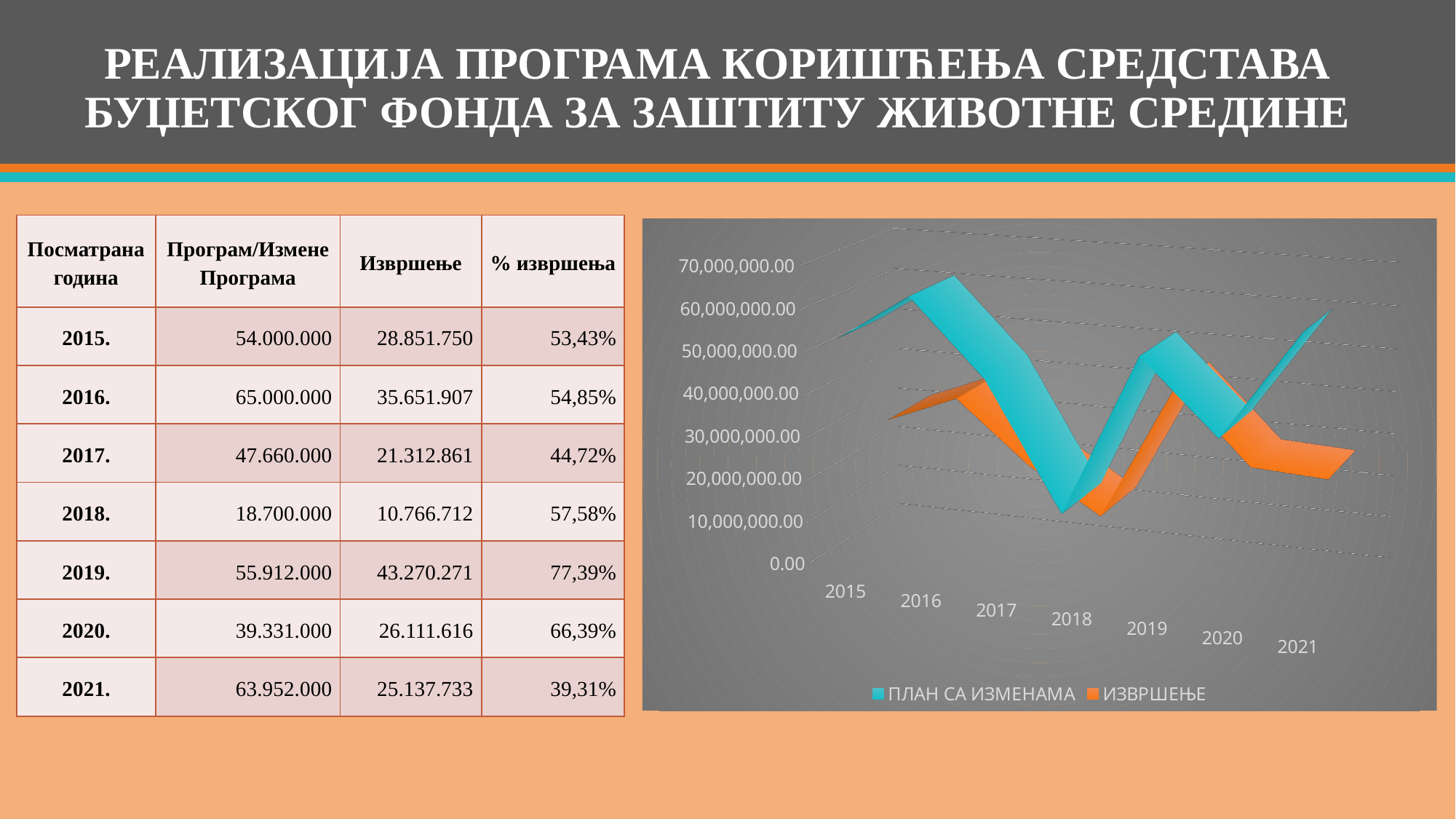
Which year has the lowest value for ИЗВРШЕЊЕ in the chart? 2018 Does the ПЛАН СА ИЗМЕНАМА series rise or fall from 2016 to 2018? fall Which series in the chart legend is shown in orange? ИЗВРШЕЊЕ Which year has the highest value for ИЗВРШЕЊЕ in the chart? 2019 Is the value for ПЛАН СА ИЗМЕНАМА in 2016 greater or less than 60,000,000.00? greater How many series does the chart legend list? 2 According to the slide, what is the Извршење value for 2019? 43.270.271 Is the value for ИЗВРШЕЊЕ in 2018 greater or less than 20,000,000.00? less How many years are plotted along the x axis of the chart? 7 What kind of chart is shown on the right of the slide? line chart Which is larger in the chart: ПЛАН СА ИЗМЕНАМА in 2016 or ПЛАН СА ИЗМЕНАМА in 2017? 2016 Which year has the highest value for ПЛАН СА ИЗМЕНАМА in the chart? 2016